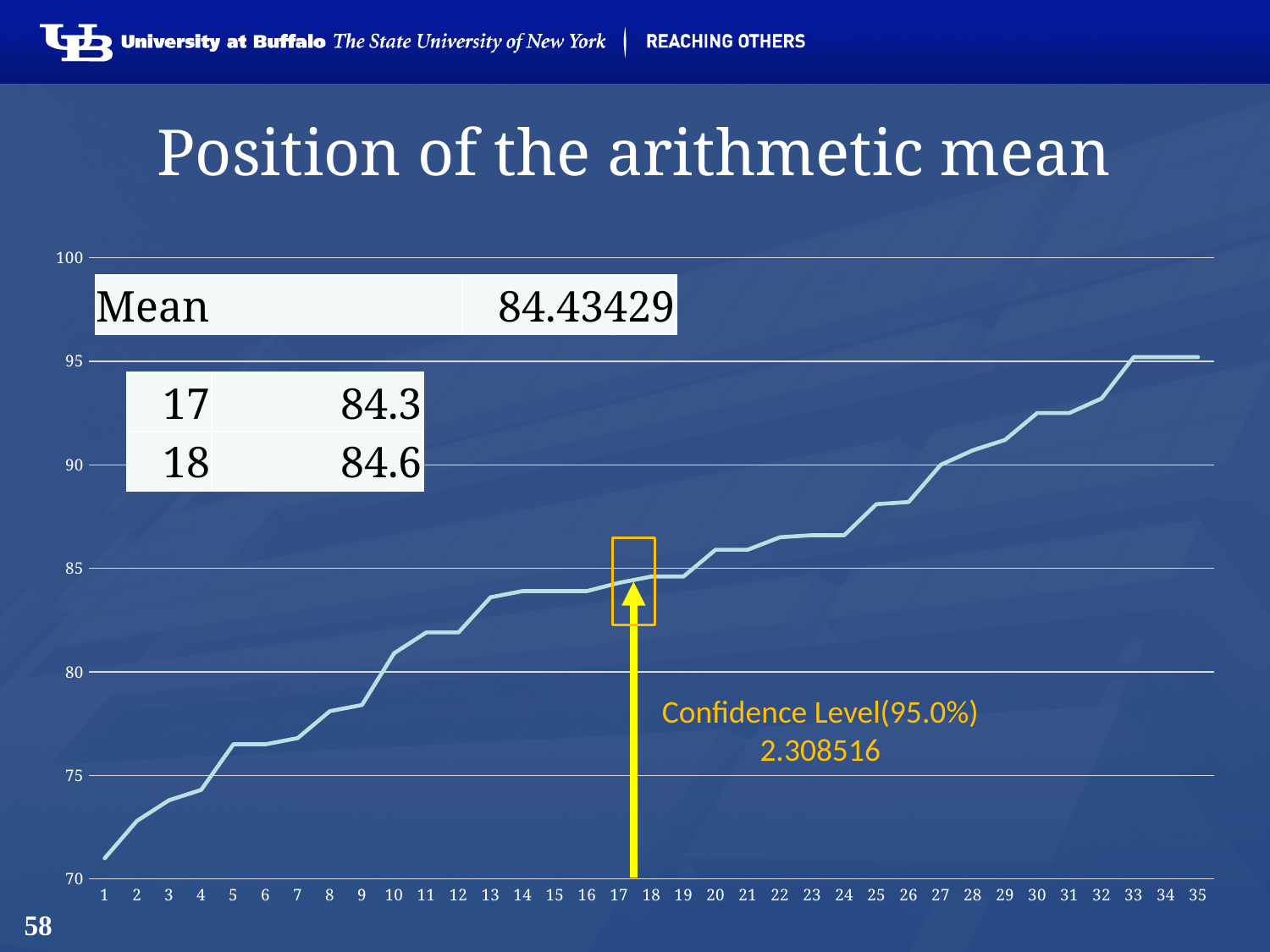
What is the title of the chart? Position of the arithmetic mean Which is larger, the value at position 17 or at position 18? 18 Is the value at position 1 greater or less than 75? less What is the value at position 18? 84.6 What is the difference between the values at positions 18 and 17? 0.3 What kind of chart is shown on the slide? line chart How many points are plotted along the x axis? 35 What is the value at position 17? 84.3 Which position has the lowest value? 1 What mean value is shown on the slide? 84.43429 Is the value at position 25 greater or less than 85? greater Do the values rise or fall as the x axis goes from 1 to 35? rise